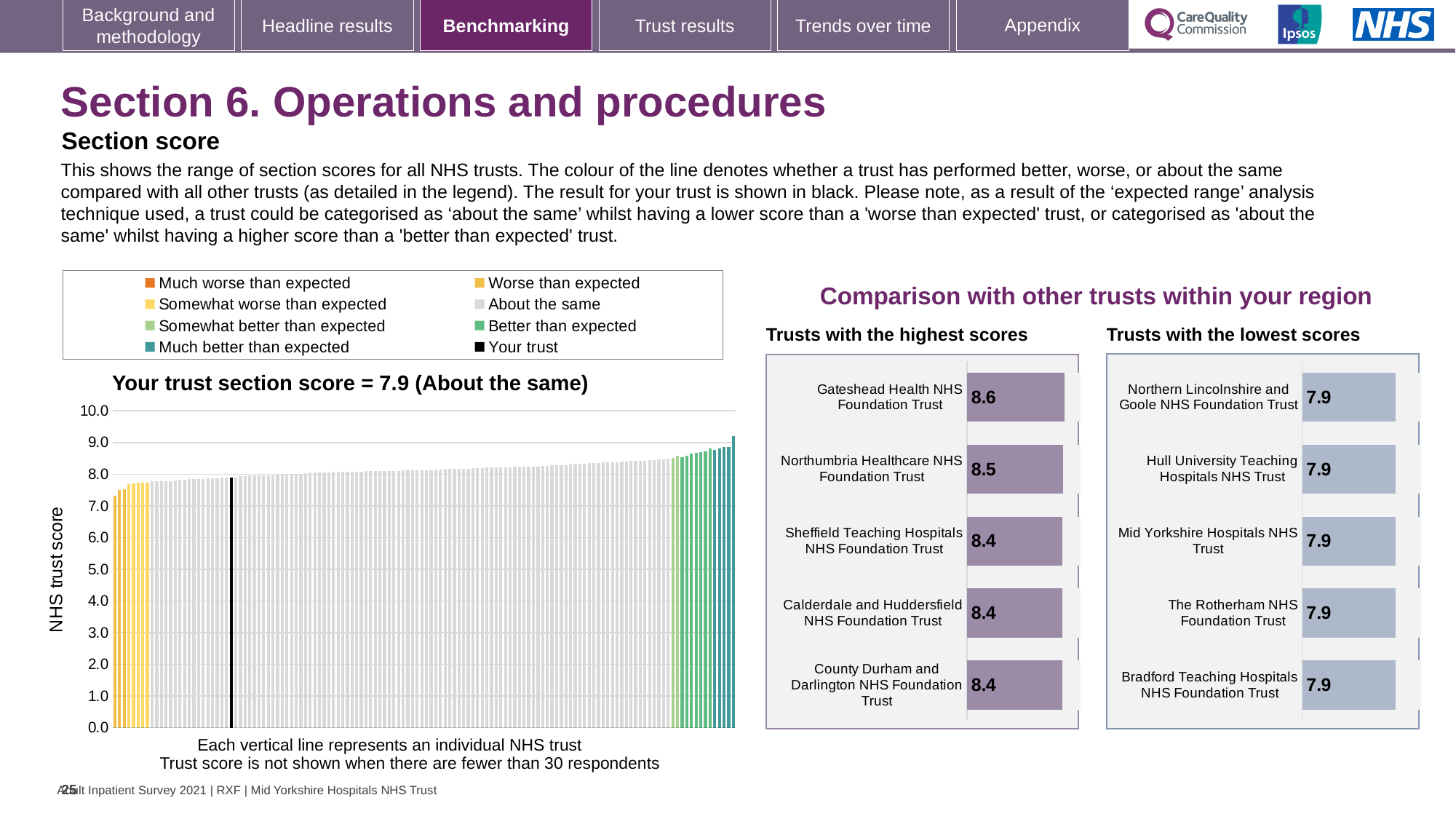
What kind of chart is the 'Your trust section score' chart? bar chart In the 'Trusts with the highest scores' chart, which trust has the highest score? Gateshead Health NHS Foundation Trust In the 'Trusts with the lowest scores' chart, what is the score for Bradford Teaching Hospitals NHS Foundation Trust? 7.9 In the 'Trusts with the highest scores' chart, what is the difference between the scores of Gateshead Health NHS Foundation Trust and Northumbria Healthcare NHS Foundation Trust? 0.1 In the 'Your trust section score' chart, what is the section score for your trust? 7.9 In the 'Trusts with the highest scores' chart, how many trusts are listed? 5 In the 'Trusts with the highest scores' chart, what is the score for Gateshead Health NHS Foundation Trust? 8.6 What is the difference between the score for Gateshead Health NHS Foundation Trust (highest scores chart) and Hull University Teaching Hospitals NHS Trust (lowest scores chart)? 0.7 In the 'Your trust section score' chart, do the bar heights rise or fall from left to right? rise In the 'Trusts with the highest scores' chart, what is the score for Northumbria Healthcare NHS Foundation Trust? 8.5 In the 'Trusts with the lowest scores' chart, what is the score for Mid Yorkshire Hospitals NHS Trust? 7.9 Which is larger: the score for Gateshead Health NHS Foundation Trust in the highest scores chart or the score for The Rotherham NHS Foundation Trust in the lowest scores chart? Gateshead Health NHS Foundation Trust